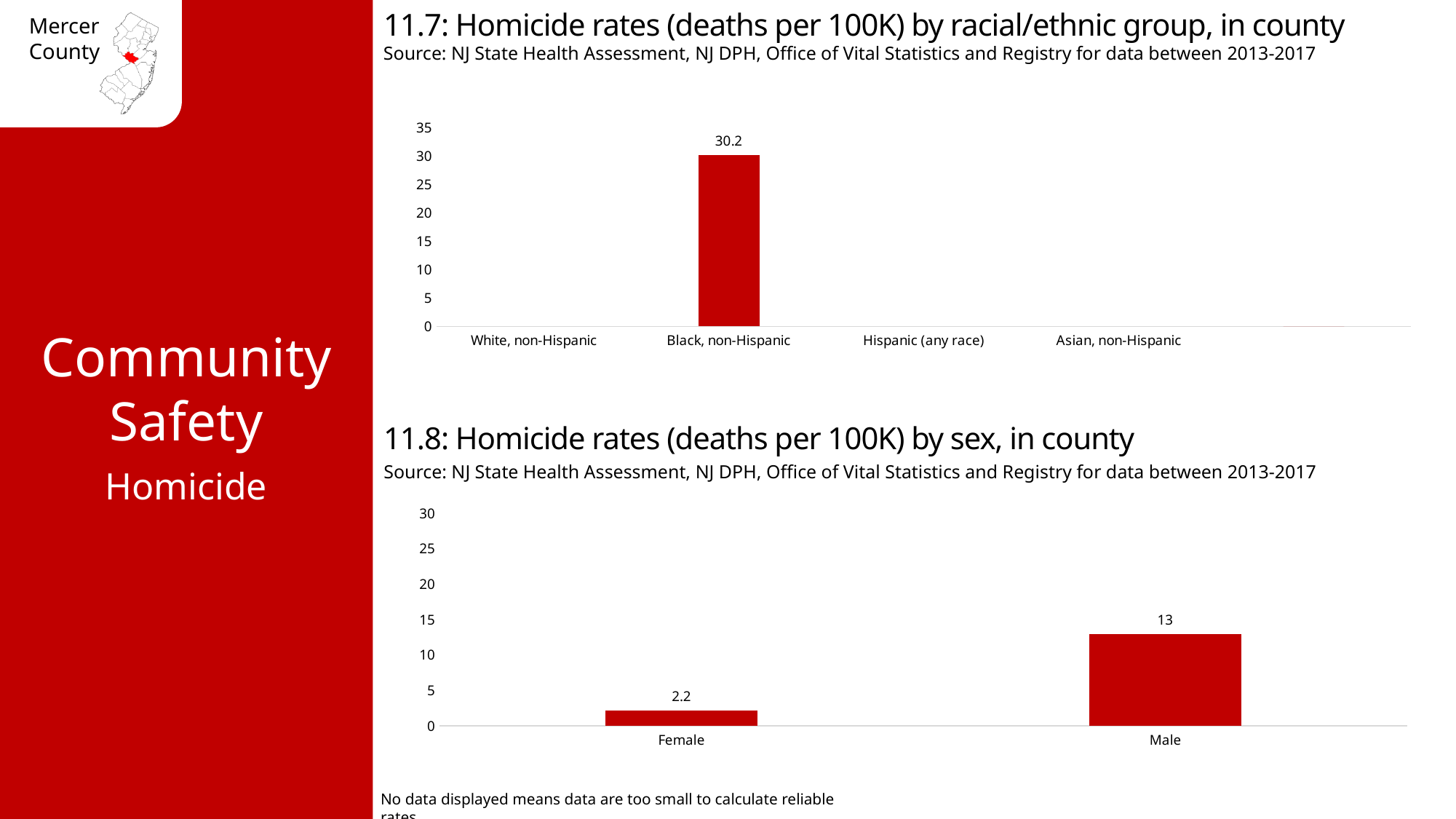
In the chart '11.8: Homicide rates (deaths per 100K) by sex, in county', what is the homicide rate for Male? 13 In the chart '11.7: Homicide rates (deaths per 100K) by racial/ethnic group, in county', how many racial/ethnic group categories are labelled on the x axis? 4 In the chart '11.7: Homicide rates (deaths per 100K) by racial/ethnic group, in county', what is the homicide rate for Black, non-Hispanic? 30.2 In the chart '11.8: Homicide rates (deaths per 100K) by sex, in county', which sex has the higher homicide rate? Male What kind of chart is '11.7: Homicide rates (deaths per 100K) by racial/ethnic group, in county'? bar chart In the chart '11.8: Homicide rates (deaths per 100K) by sex, in county', is the value for Male greater or less than 10? greater In the chart '11.7: Homicide rates (deaths per 100K) by racial/ethnic group, in county', which group has a bar displayed? Black, non-Hispanic In the chart '11.8: Homicide rates (deaths per 100K) by sex, in county', how many categories are shown? 2 In the chart '11.8: Homicide rates (deaths per 100K) by sex, in county', what is the homicide rate for Female? 2.2 In the chart '11.8: Homicide rates (deaths per 100K) by sex, in county', what is the difference between the Male and Female homicide rates? 10.8 In the chart '11.7: Homicide rates (deaths per 100K) by racial/ethnic group, in county', is the value for Black, non-Hispanic greater or less than 25? greater What is the source cited for the chart '11.8: Homicide rates (deaths per 100K) by sex, in county'? NJ State Health Assessment, NJ DPH, Office of Vital Statistics and Registry for data between 2013-2017